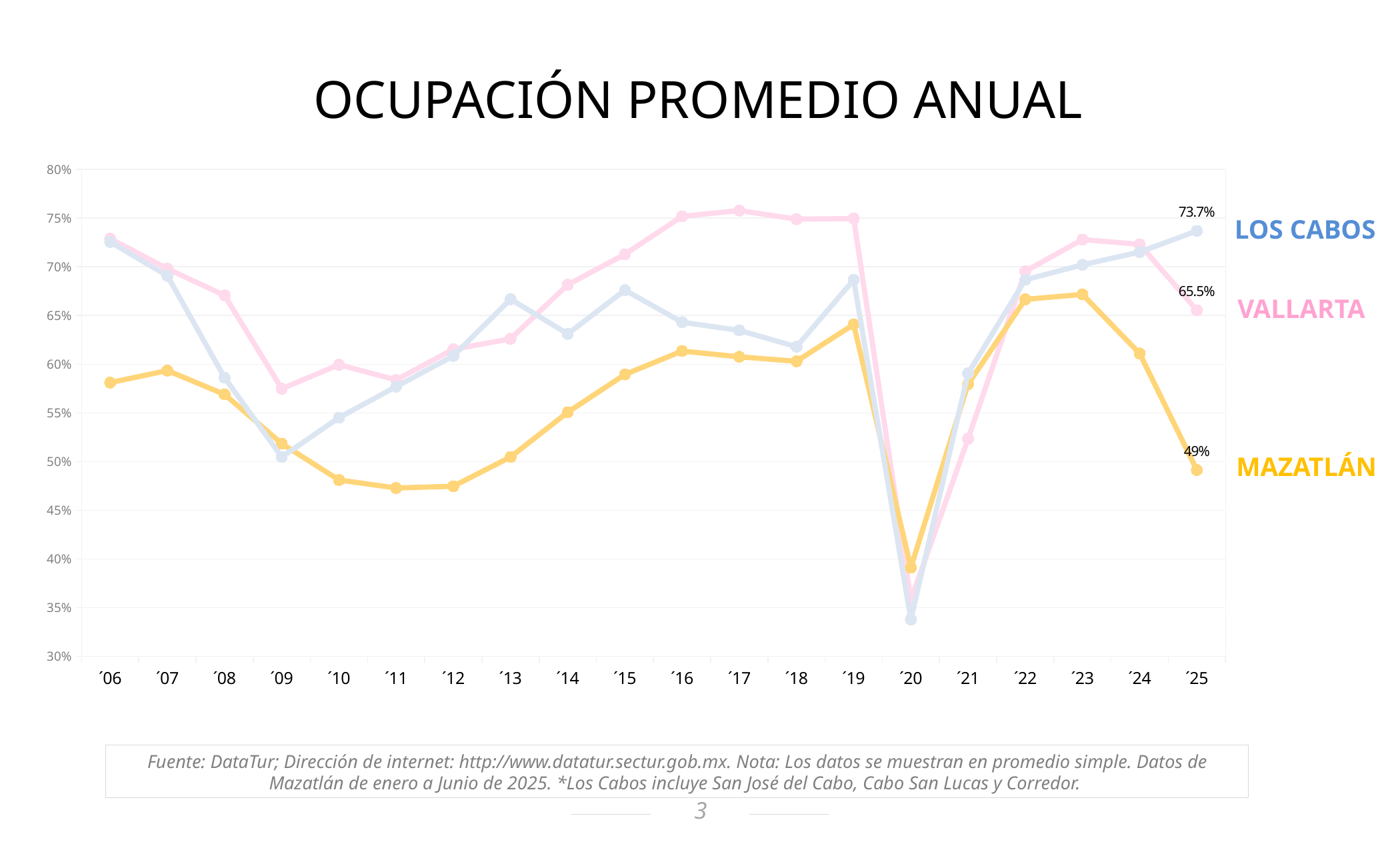
In which year do all three destinations reach their lowest occupancy? '20 How many series (destinations) are plotted on the chart? 3 Which destination has the highest occupancy in '25? Los Cabos What is the occupancy value for Los Cabos in '25? 73.7% Does the Mazatlán line rise or fall from '22 to '25? Fall What is the occupancy value for Mazatlán in '25? 49% What is the difference between the Los Cabos and Vallarta values in '25? 8.2 percentage points What kind of chart is shown on the slide? Line chart How many years are plotted on the x axis? 20 Which destination has the lowest occupancy in '25? Mazatlán What is the occupancy value for Vallarta in '25? 65.5% Is the value for Mazatlán in '20 greater or less than 45%? less